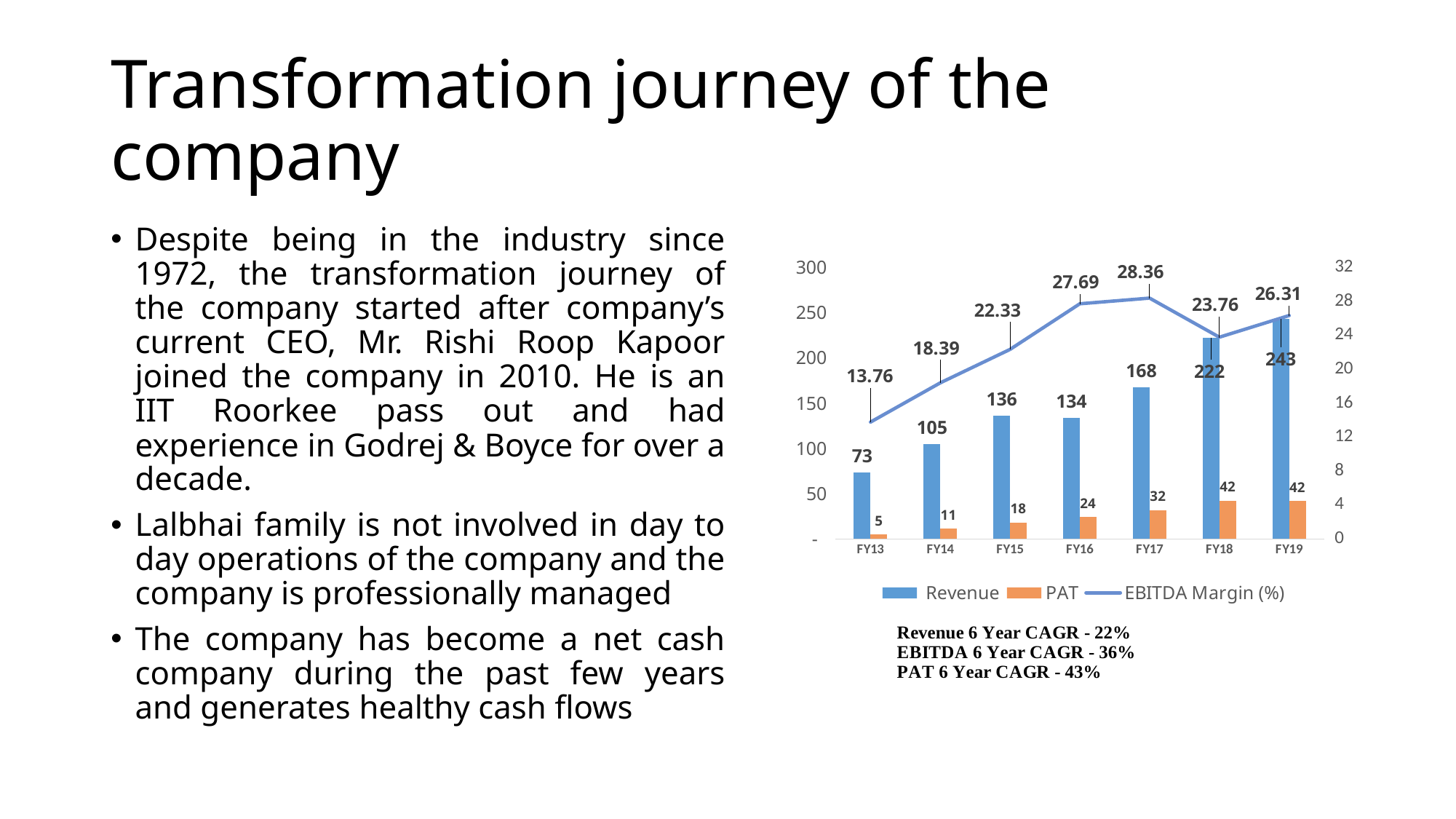
How many fiscal years are shown on the x axis? 7 What kind of chart is shown on the slide? Combined bar and line chart What is the EBITDA Margin (%) for FY15? 22.33 What is the difference between Revenue in FY19 and Revenue in FY18? 21 Does PAT rise or fall from FY13 to FY18? Rise How many series does the legend list? 3 What is the Revenue value for FY17? 168 In which fiscal year is Revenue highest? FY19 In which fiscal year is the EBITDA Margin (%) highest? FY17 In which fiscal year is the EBITDA Margin (%) lowest? FY13 Which is larger, Revenue in FY15 or Revenue in FY16? FY15 What is the PAT value for FY16? 24